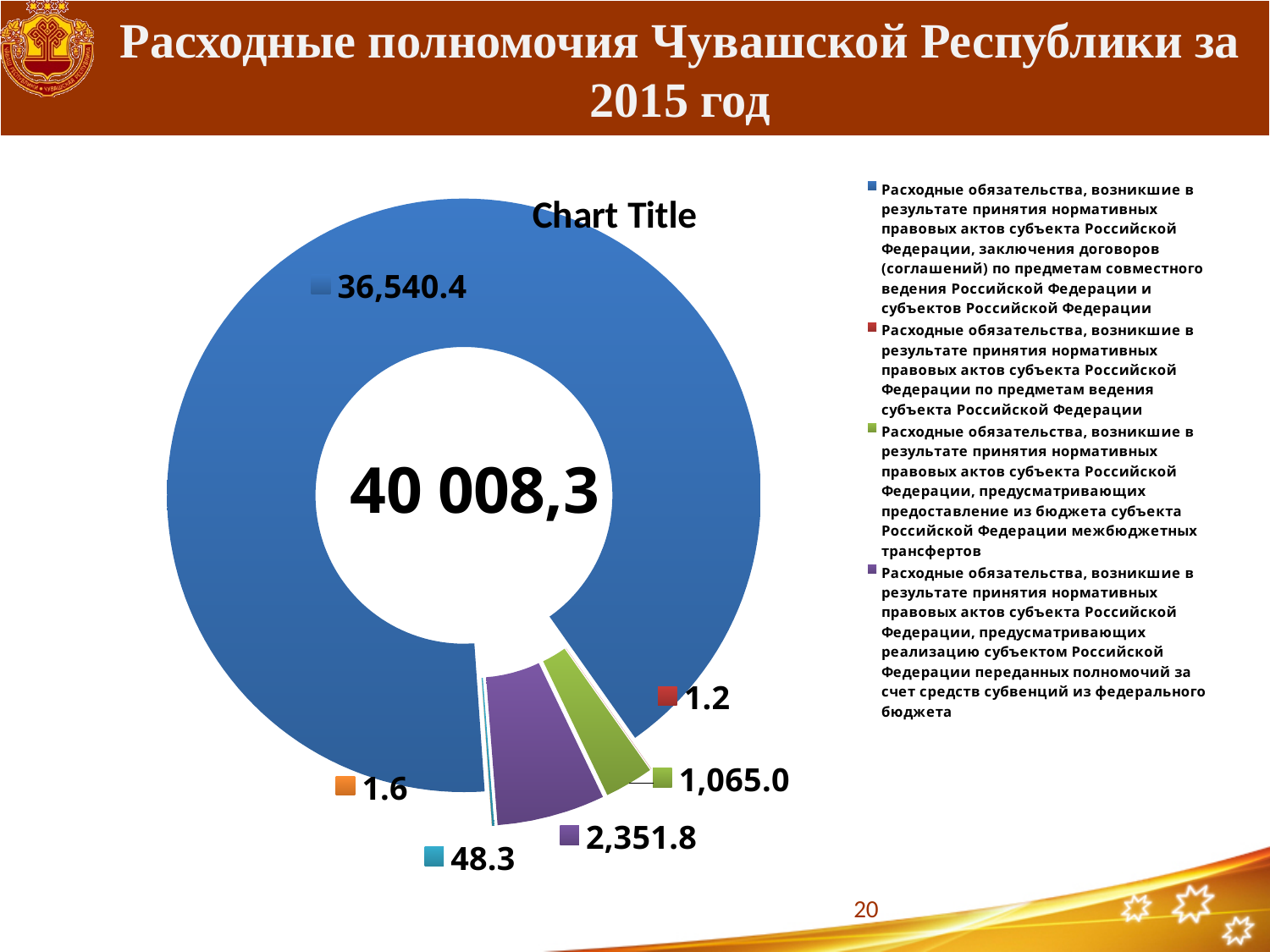
What type of chart is shown on the slide? Doughnut (pie) chart What value is labelled on the green slice, corresponding to the legend entry about inter-budget transfers (межбюджетных трансфертов)? 1,065.0 Which slice is larger, the purple one or the green one? The purple one (2,351.8) How many data labels (slice values) are shown on the chart? 6 What value is labelled on the red slice of the chart? 1.2 Which labelled value on the chart is the smallest? 1.2 Which labelled value on the chart is the largest? 36,540.4 How many entries does the legend list? 4 What value is labelled on the purple slice, corresponding to the legend entry about expenditure obligations for delegated powers funded by federal subventions? 2,351.8 What value is labelled on the cyan (light blue) slice of the chart? 48.3 What value is shown for the largest (blue) slice of the doughnut chart? 36,540.4 What is the difference between the purple slice (2,351.8) and the green slice (1,065.0)? 1,286.8